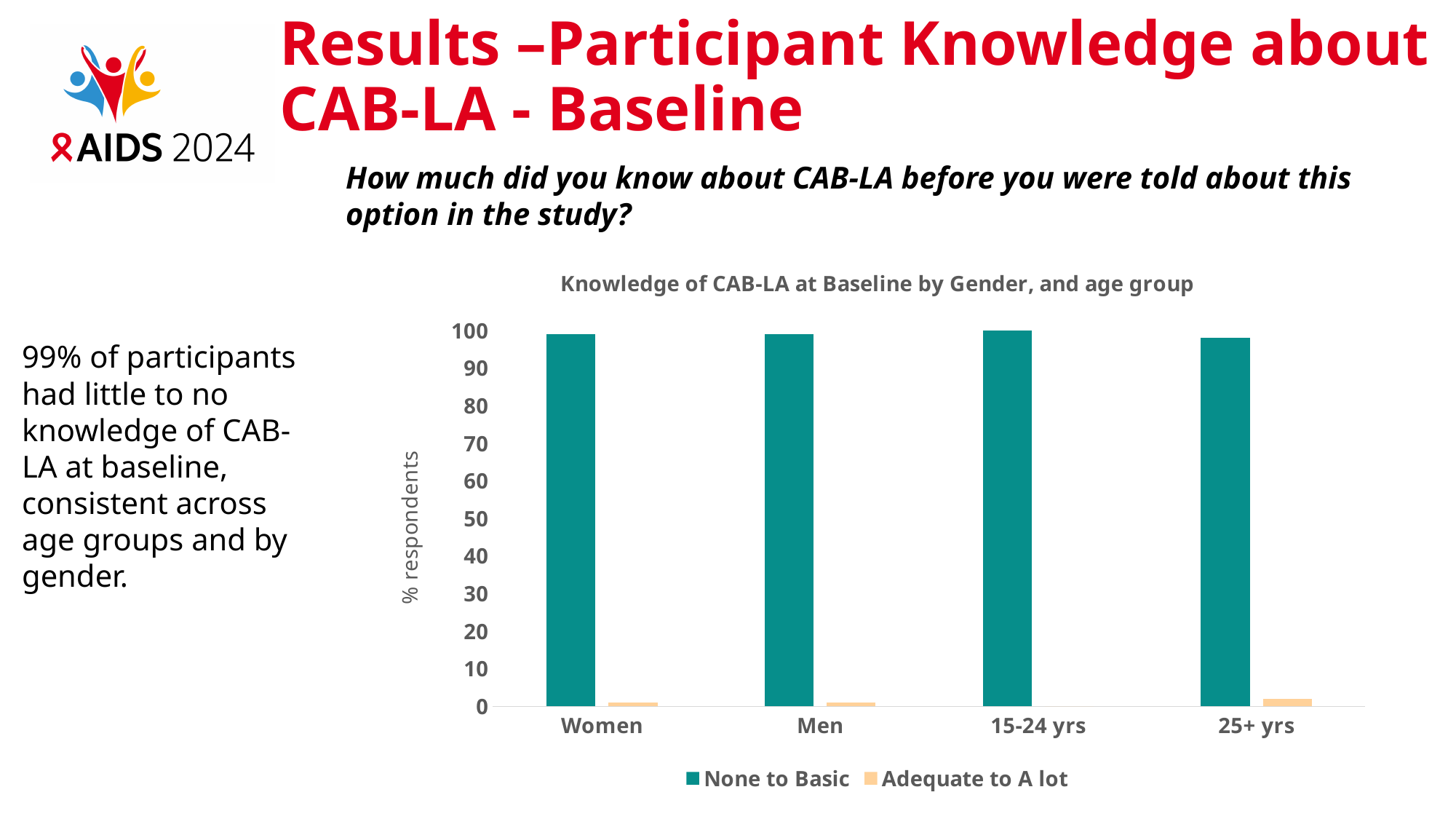
How many series does the chart's legend list? 2 Is the value for None to Basic among Men greater or less than 80? greater Is the value for Adequate to A lot among 25+ yrs greater or less than 10? less What kind of chart is shown on the slide? bar chart For 25+ yrs, which series has the smaller value: None to Basic or Adequate to A lot? Adequate to A lot What is the title of the chart? Knowledge of CAB-LA at Baseline by Gender, and age group What is the label on the chart's y axis? % respondents How many categories are shown on the x axis of the chart? 4 Is the value for None to Basic among 15-24 yrs greater or less than 50? greater For Men, which series has the larger value: None to Basic or Adequate to A lot? None to Basic